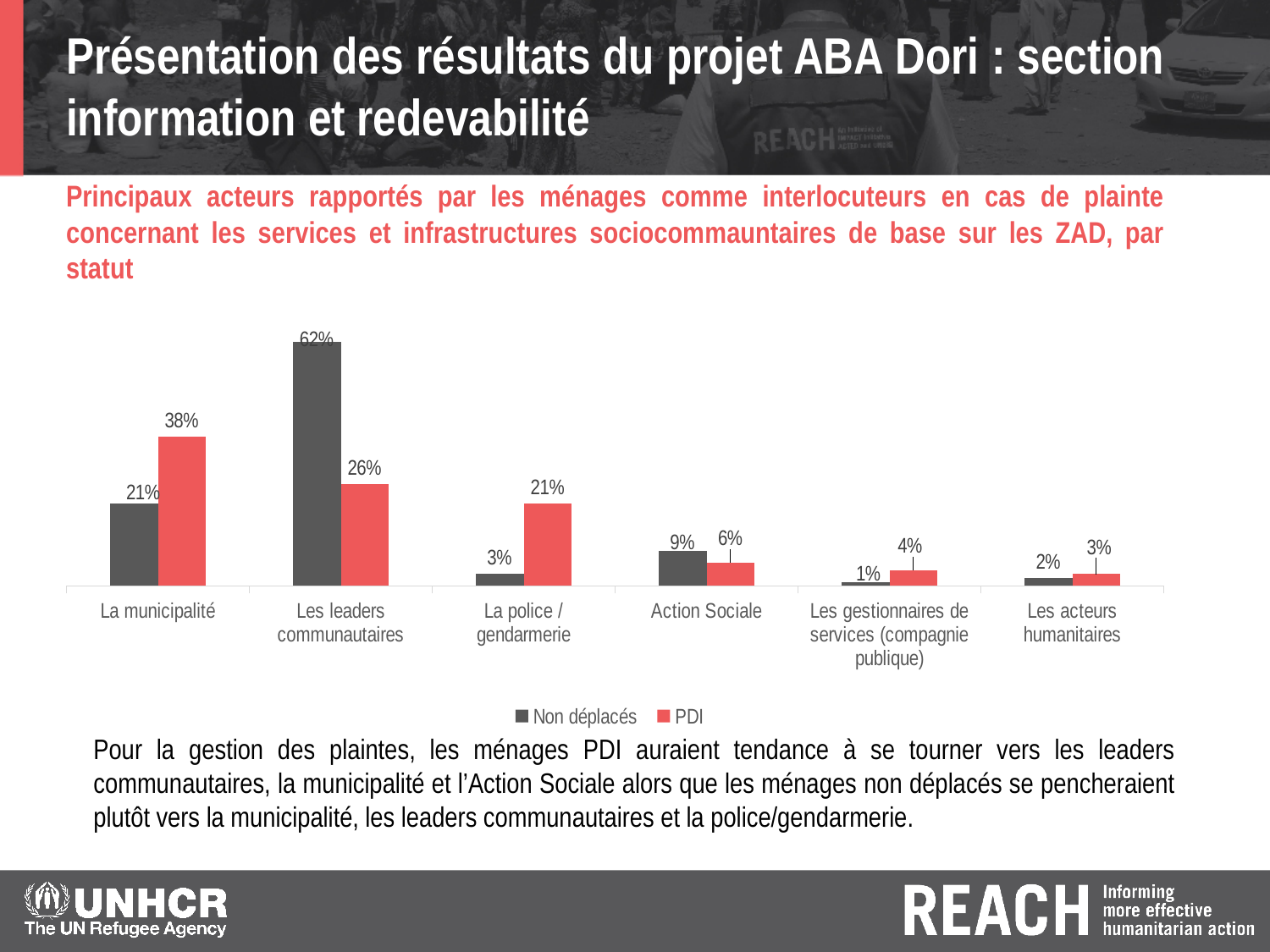
What is the value for PDI for La municipalité? 38% For La police / gendarmerie, which series has the larger value, Non déplacés or PDI? PDI What kind of chart is shown on the slide? Bar chart Which category has the highest value for Non déplacés? Les leaders communautaires Which category has the lowest value for Non déplacés? Les gestionnaires de services (compagnie publique) What is the difference between the Non déplacés and PDI values for Les leaders communautaires? 36% Which category has the highest value for PDI? La municipalité What is the value for PDI for La police / gendarmerie? 21% How many series does the legend list? 2 What is the value for Non déplacés for Les leaders communautaires? 62% How many categories are shown on the x axis? 6 What is the value for Non déplacés for Action Sociale? 9%